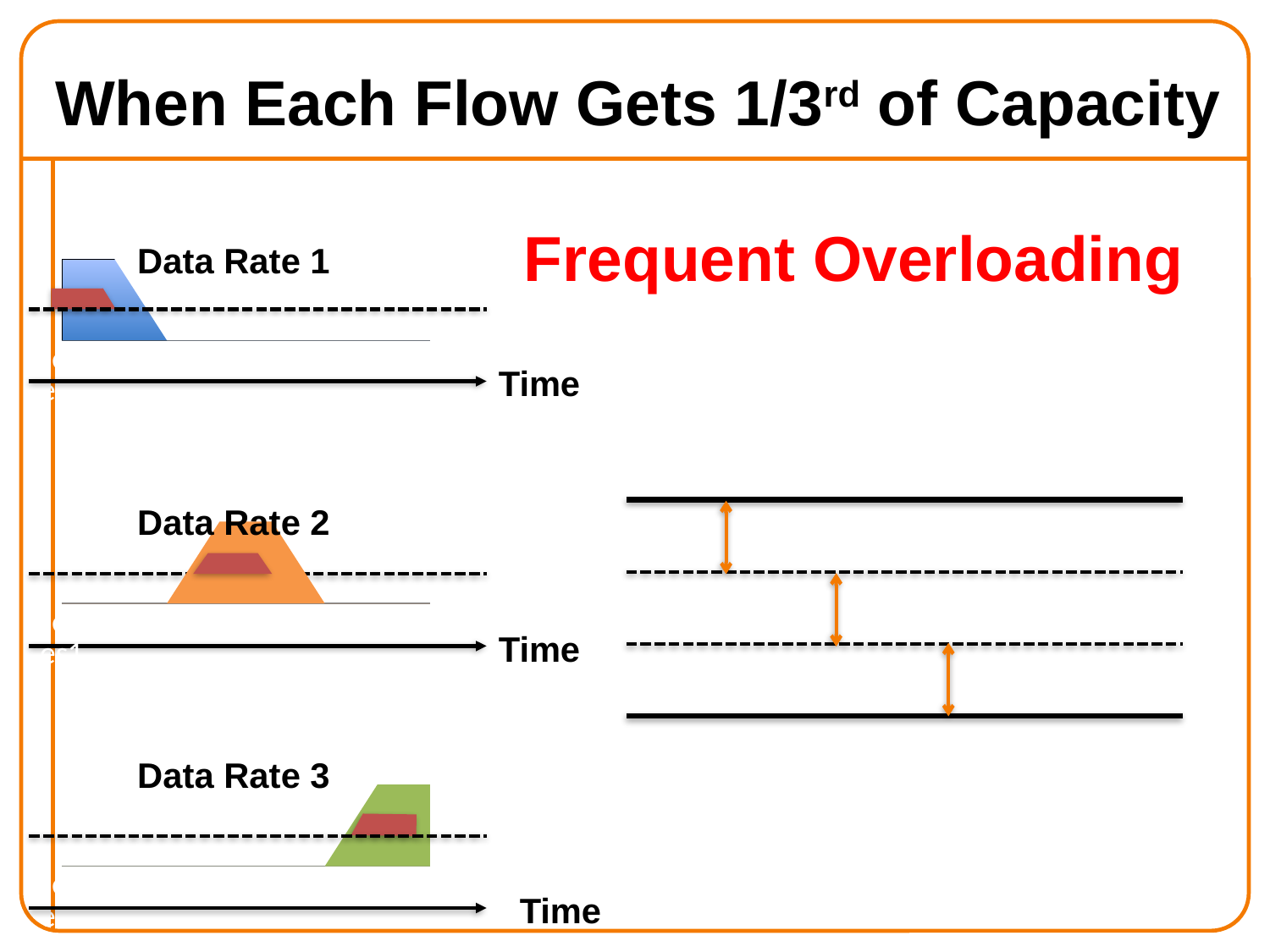
What colour is the shaded shape in the Data Rate 2 plot? orange How many data rate plots are shown on the slide? 3 In the Data Rate 3 plot, does the data rate rise or fall along the time axis? rise In the Data Rate 1 plot, does the data rate rise or fall along the time axis? fall What is the label on the horizontal axis of each data rate plot? Time